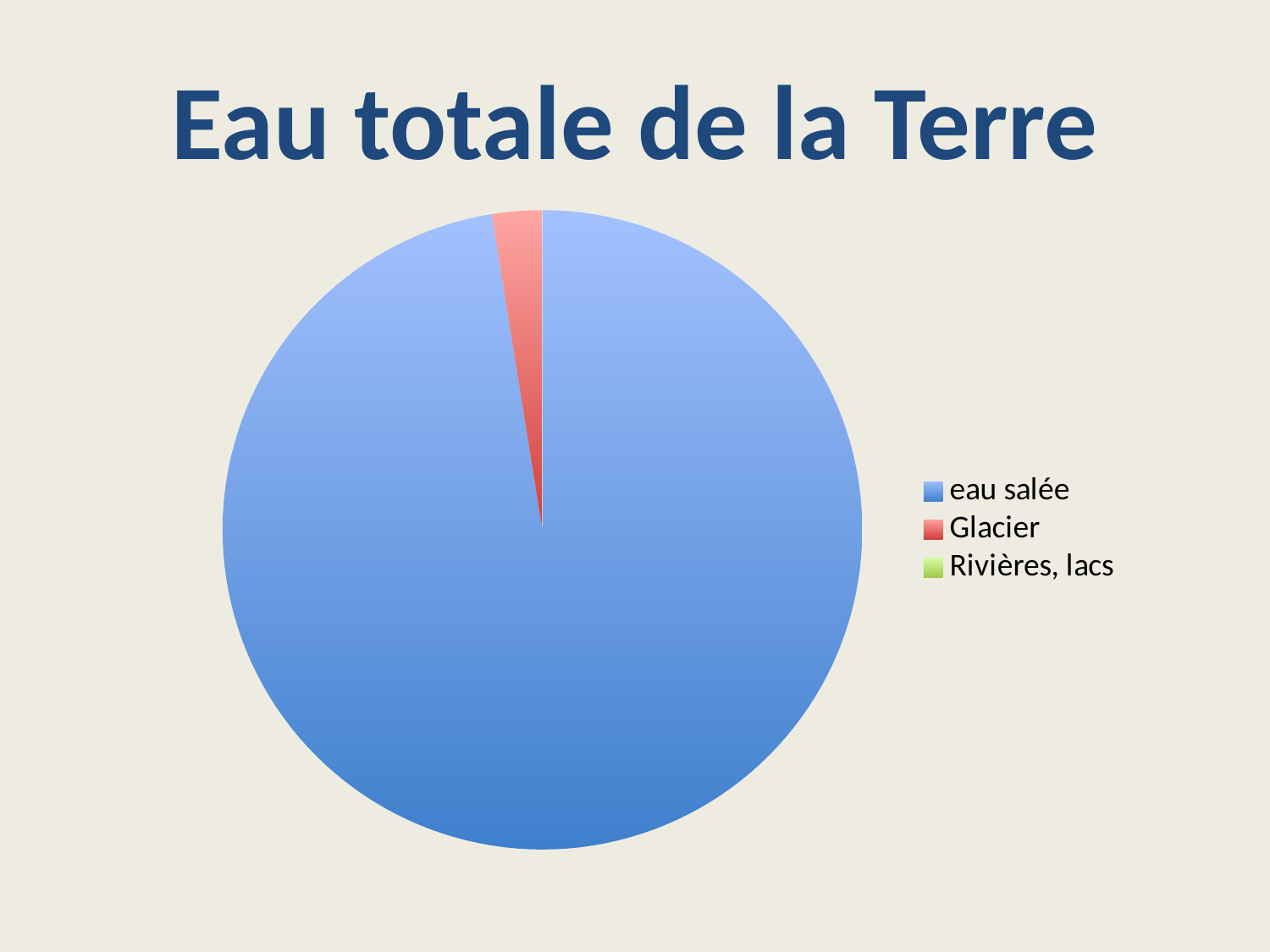
Which category has the smallest slice of the pie? Rivières, lacs What colour is the Glacier slice in the pie chart? red How many categories does the legend of the pie chart list? 3 Which slice is larger, Glacier or Rivières, lacs? Glacier What is the title of the chart? Eau totale de la Terre Which category has the largest slice of the pie? eau salée What kind of chart is shown on the slide? pie chart Which slice is larger, eau salée or Glacier? eau salée